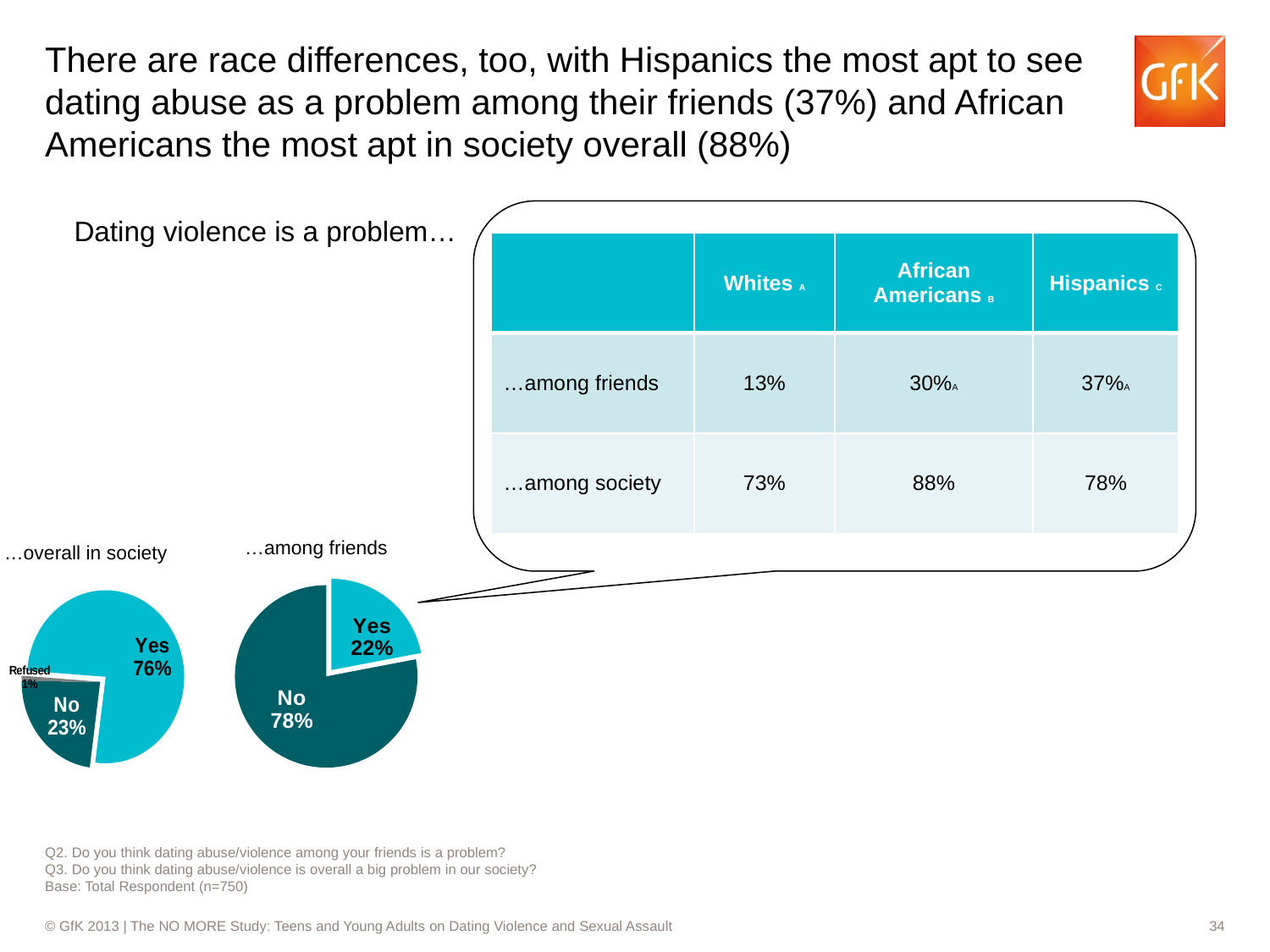
In the '…overall in society' pie chart, what percentage is labelled Refused? 1% Which is larger: the Yes share in the '…overall in society' pie chart or the Yes share in the '…among friends' pie chart? …overall in society How many slices does the '…among friends' pie chart have? 2 How many slices does the '…overall in society' pie chart have? 3 In the '…among friends' pie chart, what is the difference between the No and Yes percentages? 56% In the '…among friends' pie chart, what percentage answered No? 78% In the '…among friends' pie chart, what percentage answered Yes? 22% What type of chart is used for '…among friends'? Pie chart In the '…overall in society' pie chart, what percentage answered Yes? 76% In the '…overall in society' pie chart, which slice is the smallest? Refused In the '…among friends' pie chart, which slice is the largest? No In the '…overall in society' pie chart, what percentage answered No? 23%